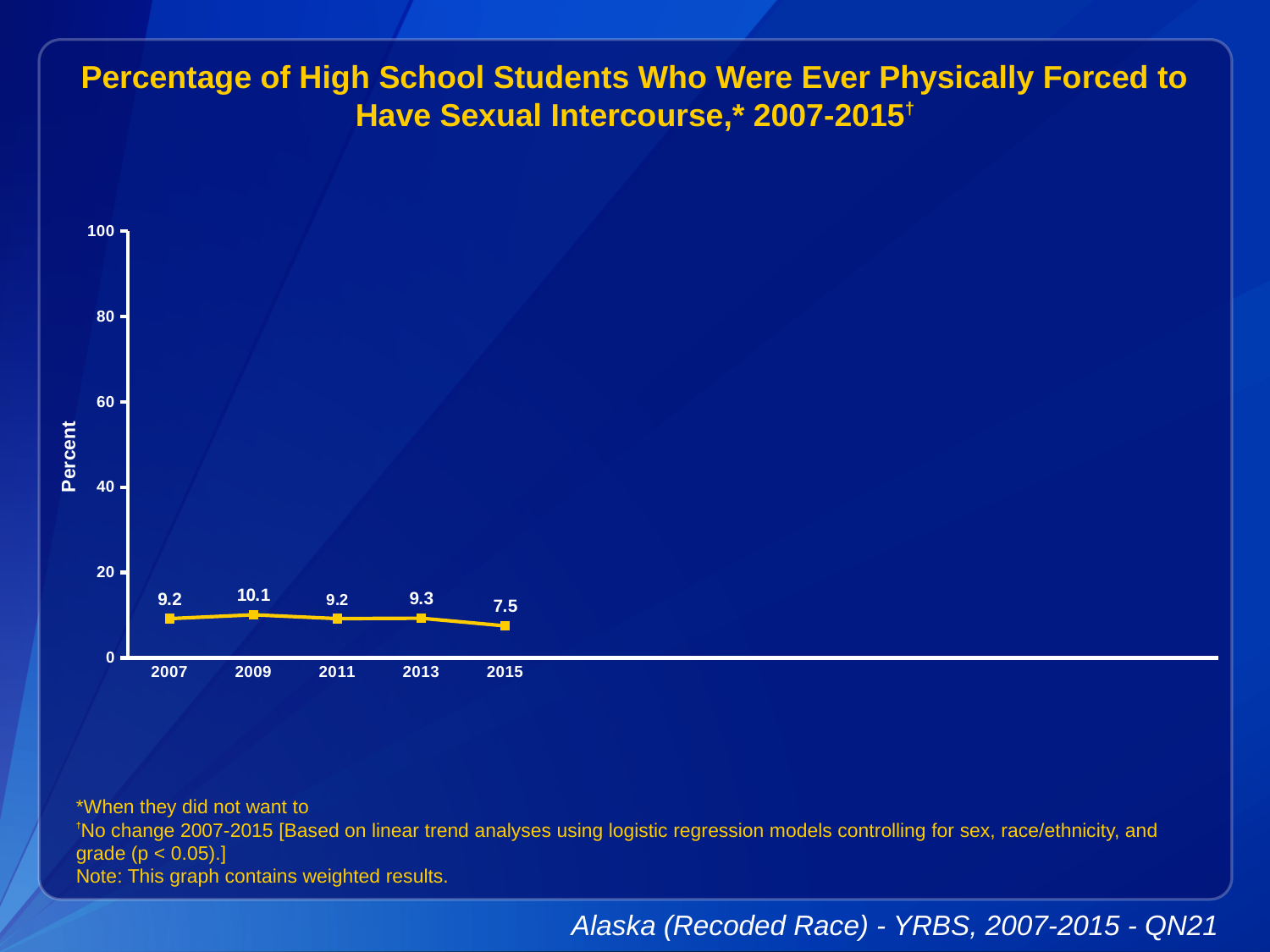
What kind of chart is shown? line chart What is the difference between the values for 2009 and 2015? 2.6 Is the value for 2009 greater or less than 20? less How many years are plotted on the chart? 5 What is the label on the y axis? Percent Does the value rise or fall from 2013 to 2015? fall What is the value for 2015? 7.5 Which year has the highest value? 2009 What is the value for 2007? 9.2 What is the value for 2009? 10.1 Which year has the lowest value? 2015 Which is larger, the value for 2013 or the value for 2015? 2013